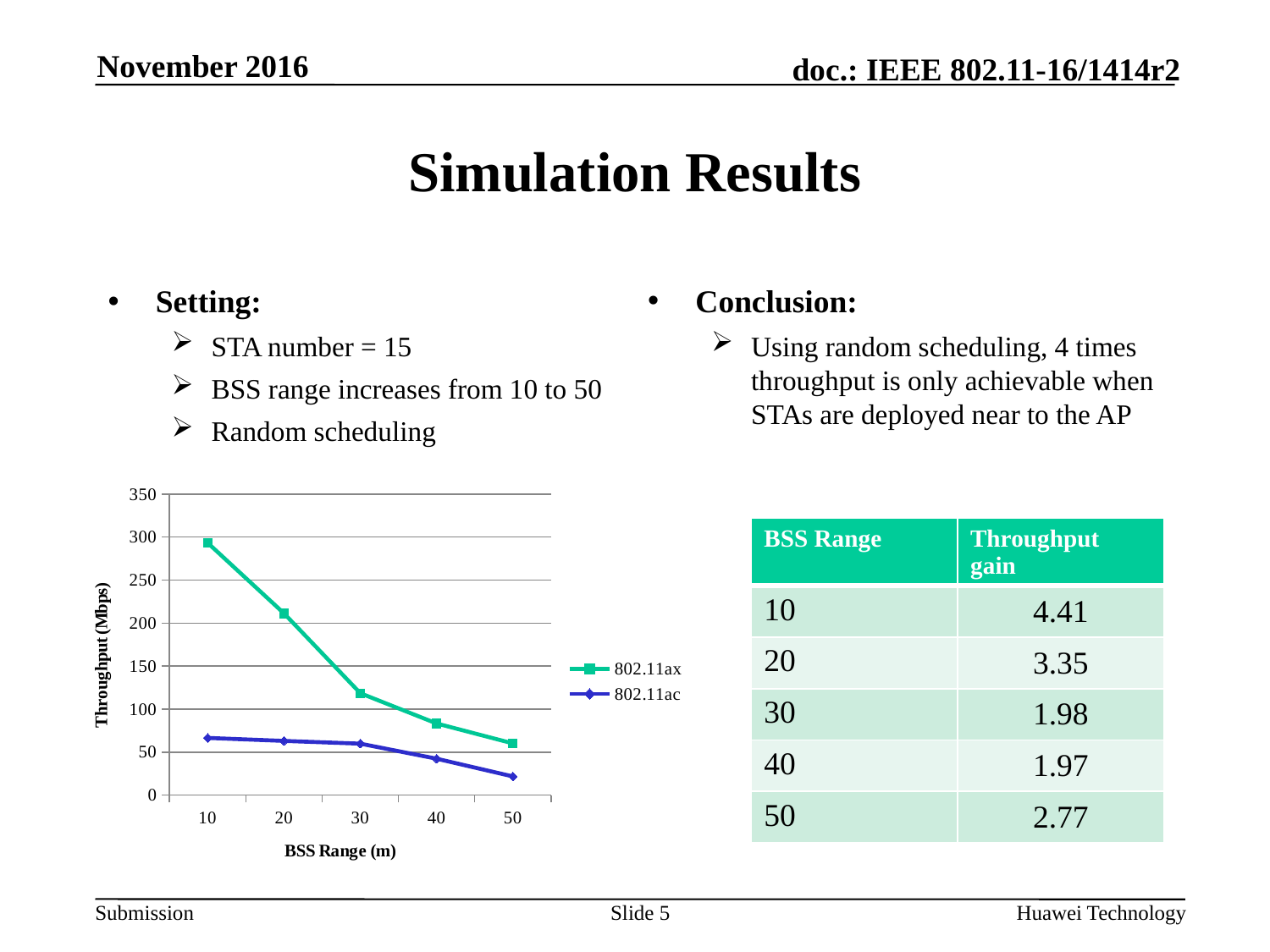
How many BSS Range values are plotted along the x axis of the chart? 5 At which BSS Range does the 802.11ax series reach its highest throughput? 10 Does the 802.11ax throughput rise or fall as BSS Range increases from 10 to 50? fall What kind of chart is shown on the slide? line chart At which BSS Range does the 802.11ac series have its lowest throughput? 50 At BSS Range 10, which series has the higher throughput, 802.11ax or 802.11ac? 802.11ax Is the 802.11ax throughput at BSS Range 30 greater or less than 150? less Is the 802.11ax throughput at BSS Range 50 greater or less than 100? less How many series does the chart legend list? 2 Is the 802.11ac throughput at BSS Range 10 greater or less than 50? greater